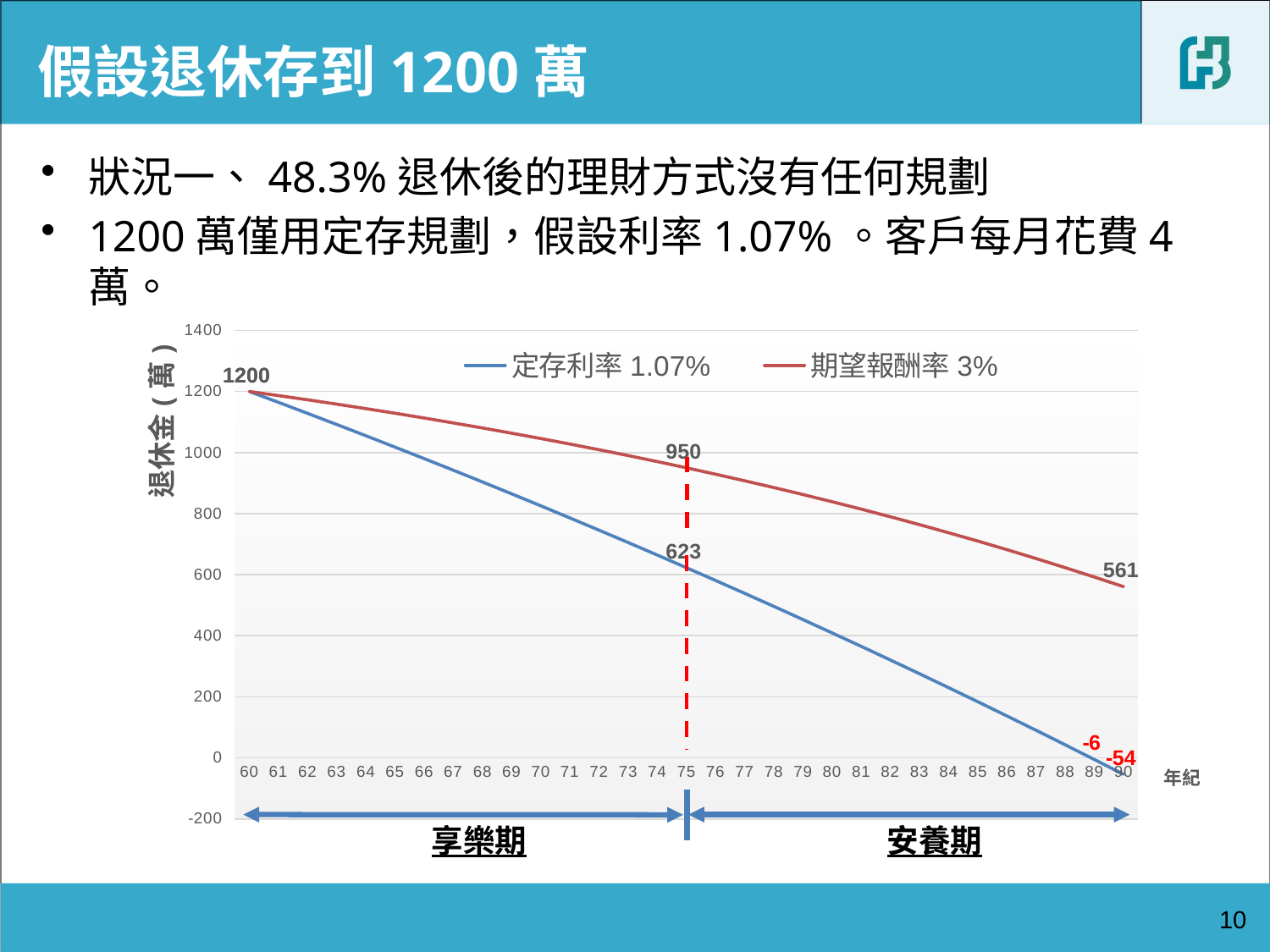
What is the value of the 期望報酬率 3% series at age 75? 950 What is the label of the y axis of the chart? 退休金(萬) Do the values of the 定存利率 1.07% series rise or fall as age increases along the x axis? fall What is the starting value of both series at age 60? 1200 How many series does the chart legend list? 2 What is the value of the 定存利率 1.07% series at age 90? -54 What is the difference between the 期望報酬率 3% and 定存利率 1.07% series at age 75? 327 At age 90, which series has the larger value, 定存利率 1.07% or 期望報酬率 3%? 期望報酬率 3% What kind of chart is shown on the slide? line chart Is the value of the 定存利率 1.07% series at age 70 greater or less than 1000? less What is the value of the 定存利率 1.07% series at age 75? 623 What is the value of the 期望報酬率 3% series at age 90? 561